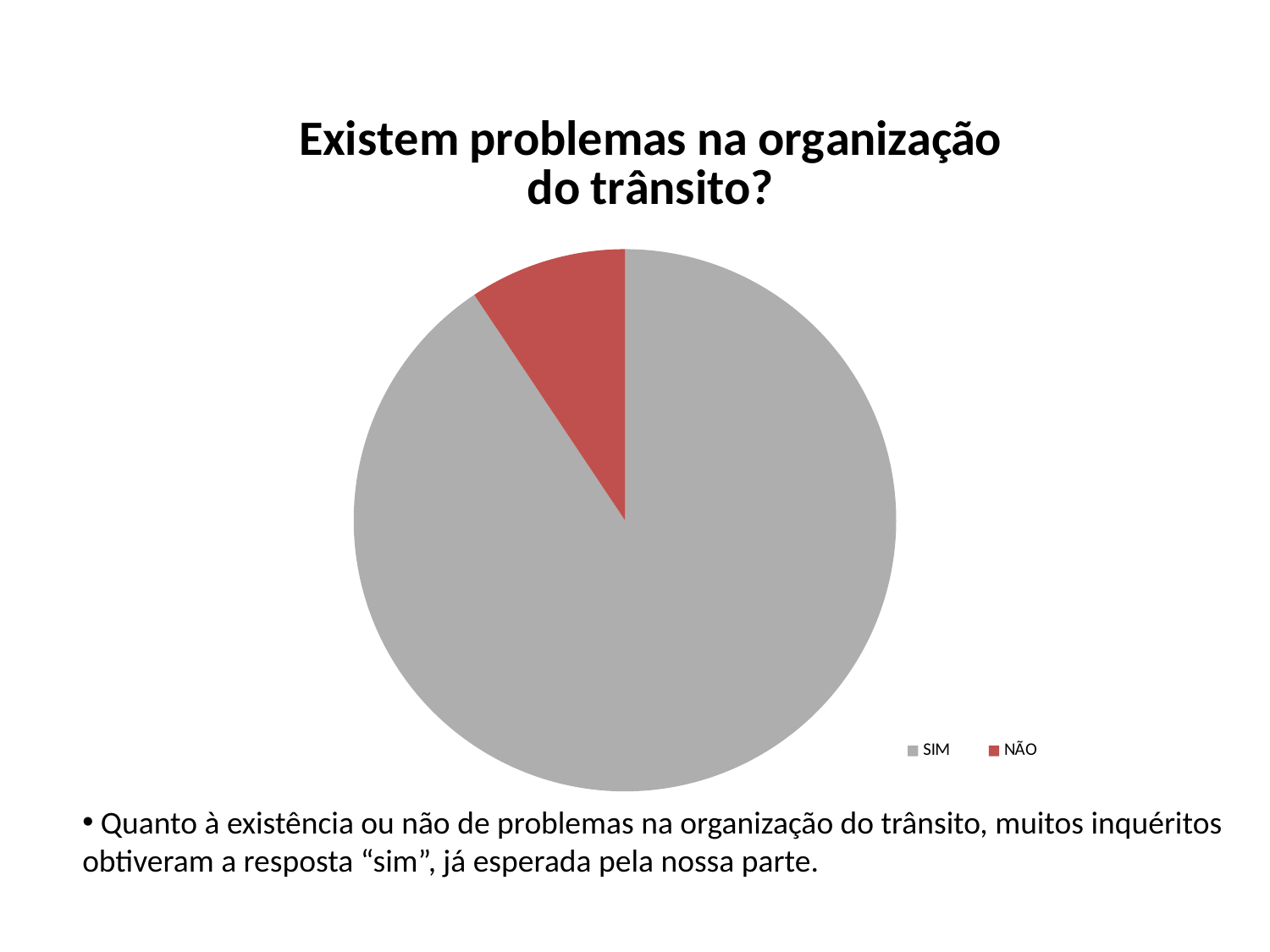
Which category has the smallest slice of the pie? NÃO Which slice is larger, SIM or NÃO? SIM What colour is the SIM slice? grey What kind of chart is shown on the slide? pie chart How many entries does the legend list? 2 What is the title of the chart? Existem problemas na organização do trânsito? Which legend entry is shown in red? NÃO Which category has the largest slice of the pie? SIM How many slices does the pie chart have? 2